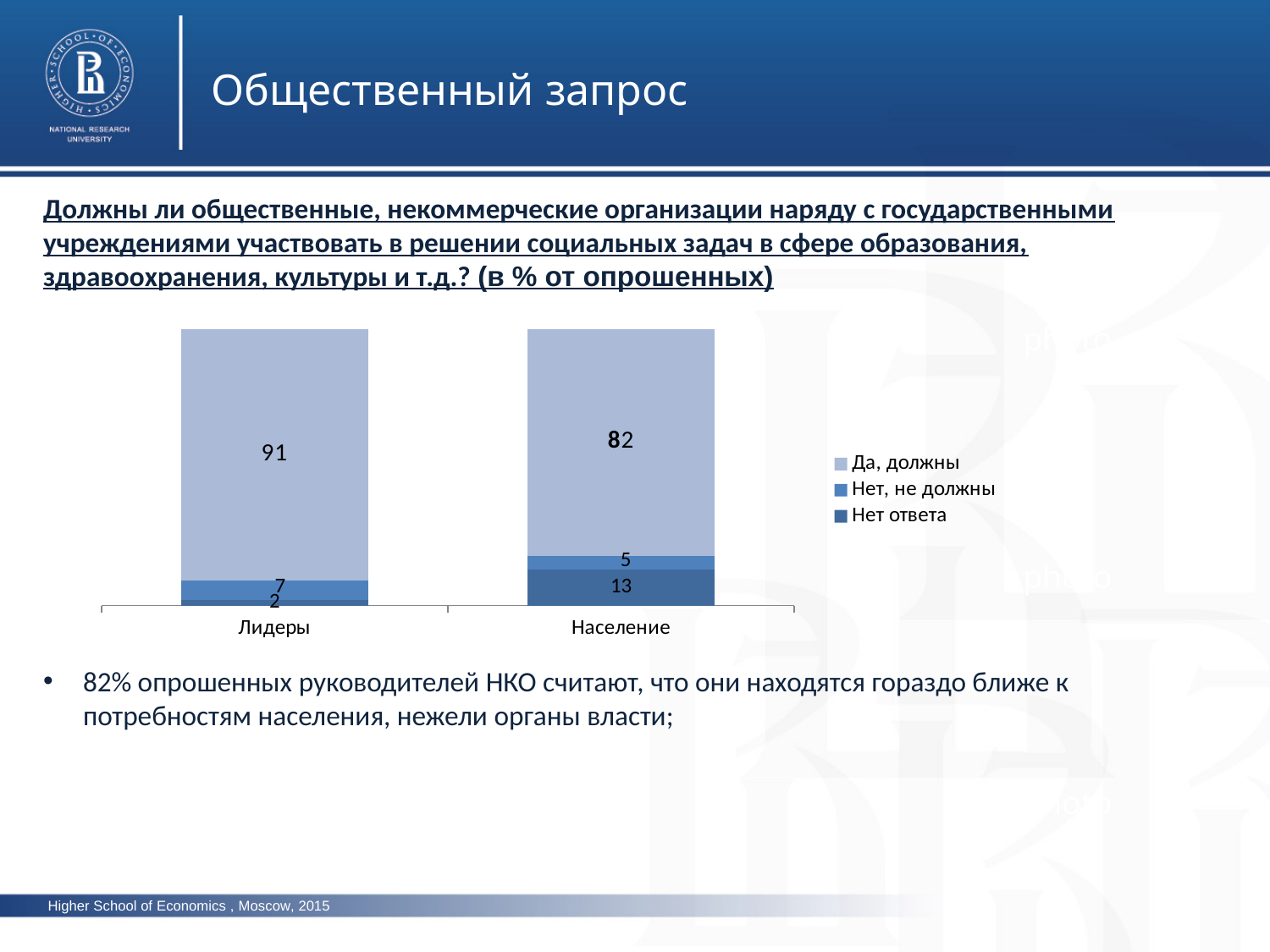
What is the value of 'Нет ответа' for Население? 13 Which category has the higher value for 'Да, должны', Лидеры or Население? Лидеры What is the difference between the 'Да, должны' values for Лидеры and Население? 9 What is the value of 'Нет, не должны' for Лидеры? 7 What is the total of the stacked bar for Население? 100 What is the value of 'Нет ответа' for Лидеры? 2 How many categories are shown on the x axis of the chart? 2 What is the value of 'Да, должны' for Население? 82 How many series does the chart legend list? 3 What kind of chart is shown on the slide? Stacked bar chart What is the value of 'Да, должны' for Лидеры? 91 Which series is listed first in the chart legend? Да, должны